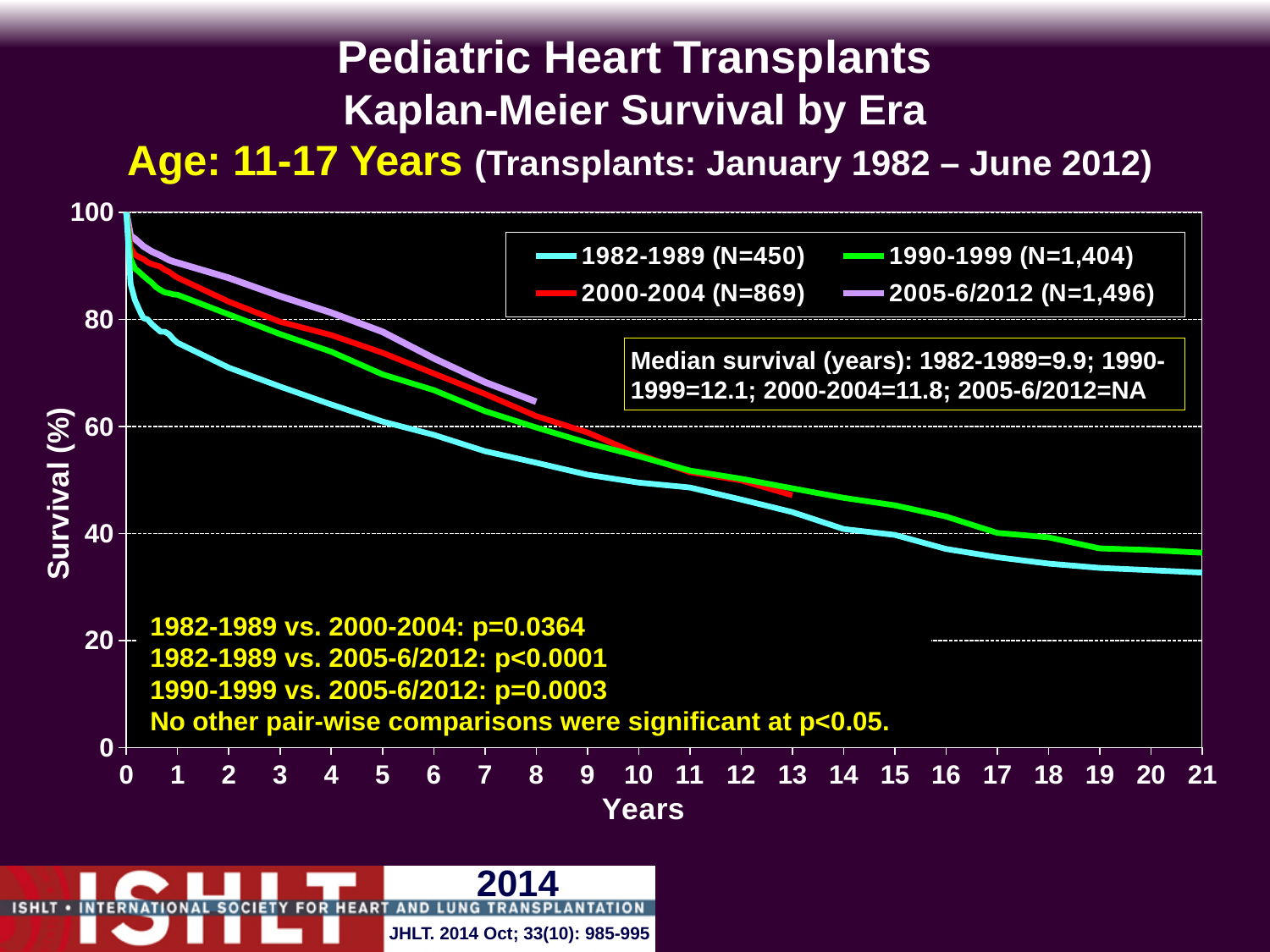
Is the survival for the 1982-1989 era at 20 years greater or less than 40? less What is the median survival in years for the 2000-2004 era? 11.8 What type of chart is shown on the slide? line chart What is the N for the 1982-1989 era shown in the legend? 450 What p-value is shown for 1982-1989 vs. 2005-6/2012? p<0.0001 What is the median survival in years for the 1990-1999 era? 12.1 How many series does the legend list? 4 Is the survival for the 1982-1989 era at 10 years greater or less than 60? less Is the survival for the 2005-6/2012 era at 5 years greater or less than 60? greater What is the label of the y axis? Survival (%) Which era has the highest survival at 3 years? 2005-6/2012 Do the survival curves rise or fall as years increase? fall